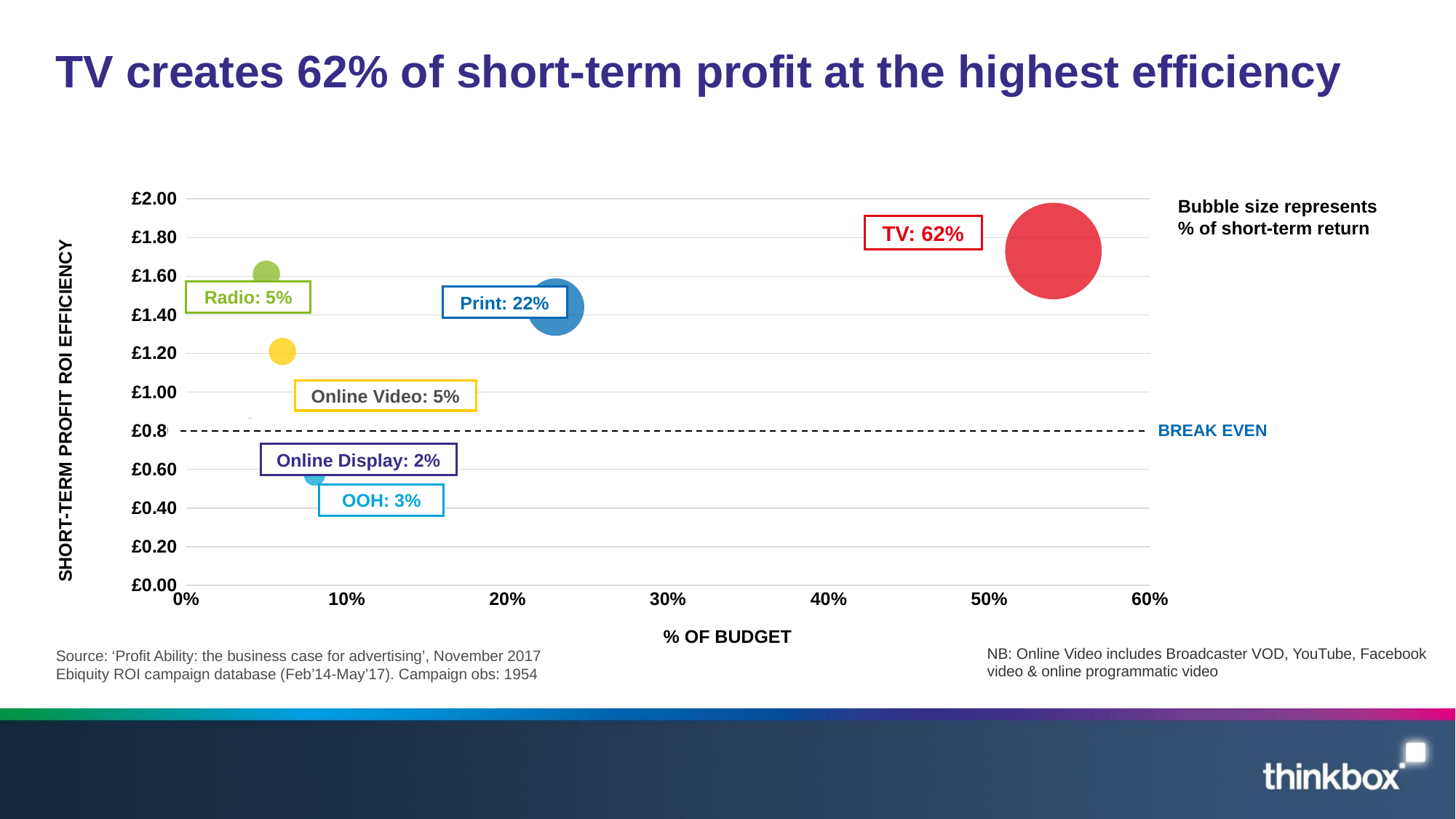
What percentage of short-term return does Print represent? 22% Is the short-term profit ROI efficiency for TV greater or less than £1.60? greater Is the short-term profit ROI efficiency for OOH greater or less than £0.80? less At what ROI efficiency value is the break even line drawn? £0.80 What percentage of short-term return does TV represent? 62% How many percentage points larger is TV's share of short-term return than Print's? 40% What kind of chart is shown on the slide? bubble chart What percentage of short-term return does OOH represent? 3% Which has a larger share of short-term return, Radio or OOH? Radio Is the % of budget for TV greater or less than 50%? greater Which medium has the largest share of short-term return? TV Which medium has the smallest share of short-term return? Online Display